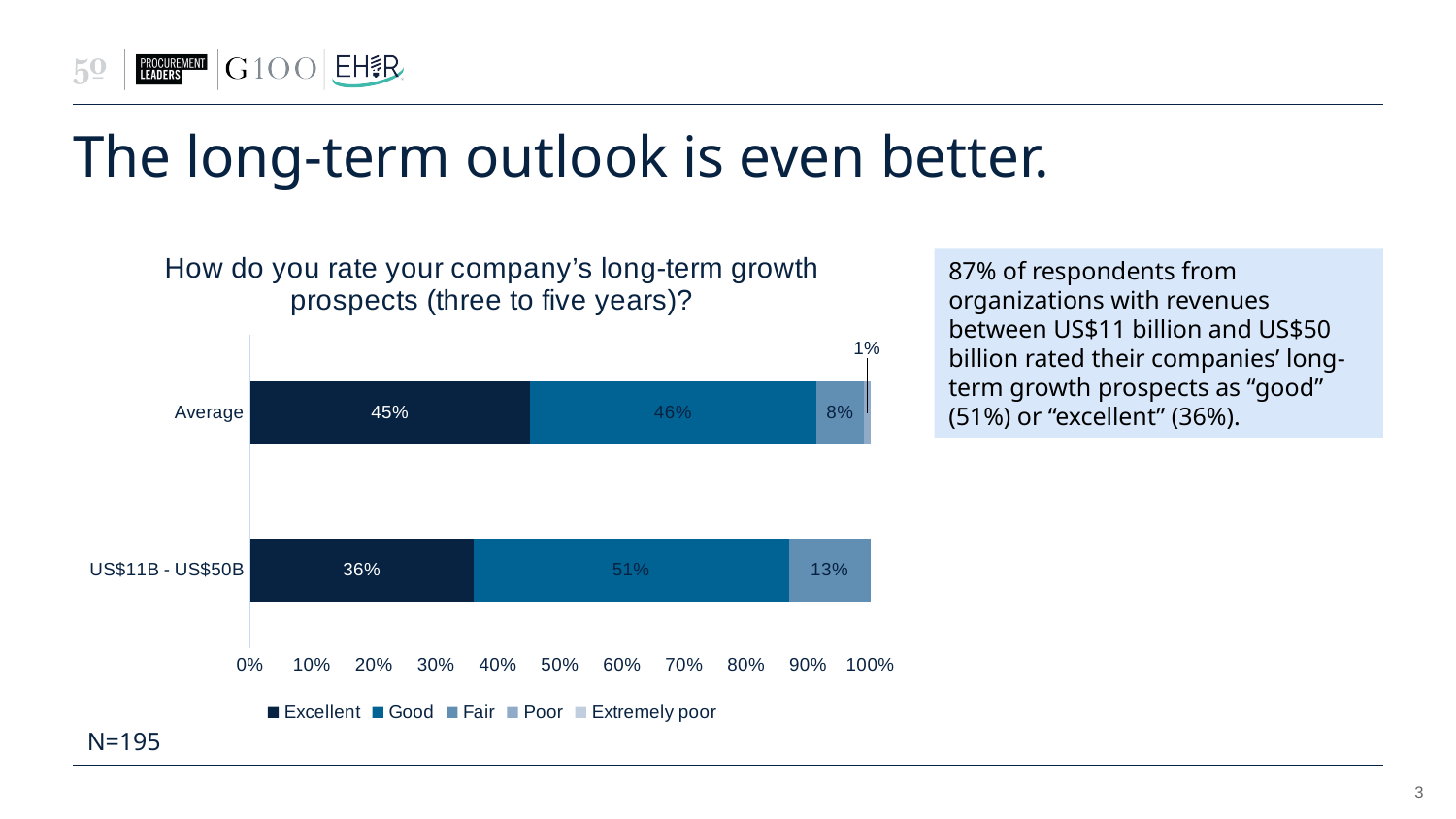
What is the Fair value for the US$11B - US$50B category? 13% What is the Fair value for the Average category? 8% What is the Good value for the US$11B - US$50B category? 51% Which category has the larger Good value, Average or US$11B - US$50B? US$11B - US$50B What is the difference between the Excellent values for Average and US$11B - US$50B? 9 percentage points Which category has the larger Excellent value, Average or US$11B - US$50B? Average What is the Excellent value for the Average category? 45% What is the title of the chart? How do you rate your company's long-term growth prospects (three to five years)? What kind of chart is shown on the slide? Stacked bar chart What is the Excellent value for the US$11B - US$50B category? 36% How many series does the legend list? 5 How many categories are shown on the y axis of the chart? 2